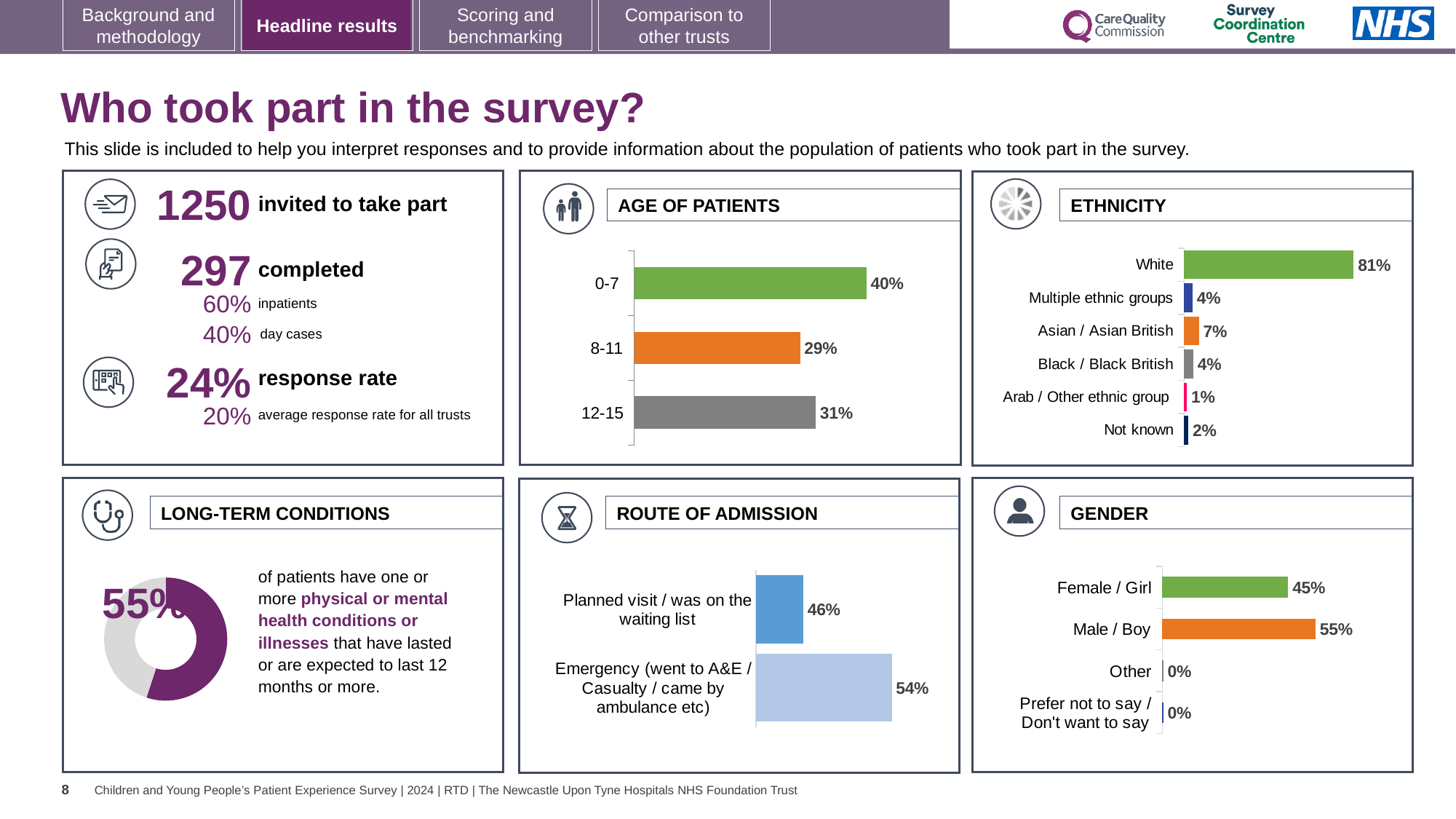
In the AGE OF PATIENTS chart, what is the value for the 8-11 age group? 29% In the ETHNICITY chart, how many categories are shown? 6 In the ETHNICITY chart, which category has the lowest value? Arab / Other ethnic group In the AGE OF PATIENTS chart, which age group has the highest value? 0-7 In the LONG-TERM CONDITIONS chart, what share of patients have one or more long-term conditions? 55% In the ROUTE OF ADMISSION chart, what is the value for Emergency (went to A&E / Casualty / came by ambulance etc)? 54% In the ETHNICITY chart, what is the difference between the values for White and Asian / Asian British? 74% In the ROUTE OF ADMISSION chart, which is larger: Planned visit / was on the waiting list or Emergency? Emergency What type of chart is used in the AGE OF PATIENTS panel? Bar chart In the GENDER chart, what is the difference between Male / Boy and Female / Girl? 10% In the GENDER chart, what is the value for Male / Boy? 55% In the ETHNICITY chart, what is the value for Asian / Asian British? 7%